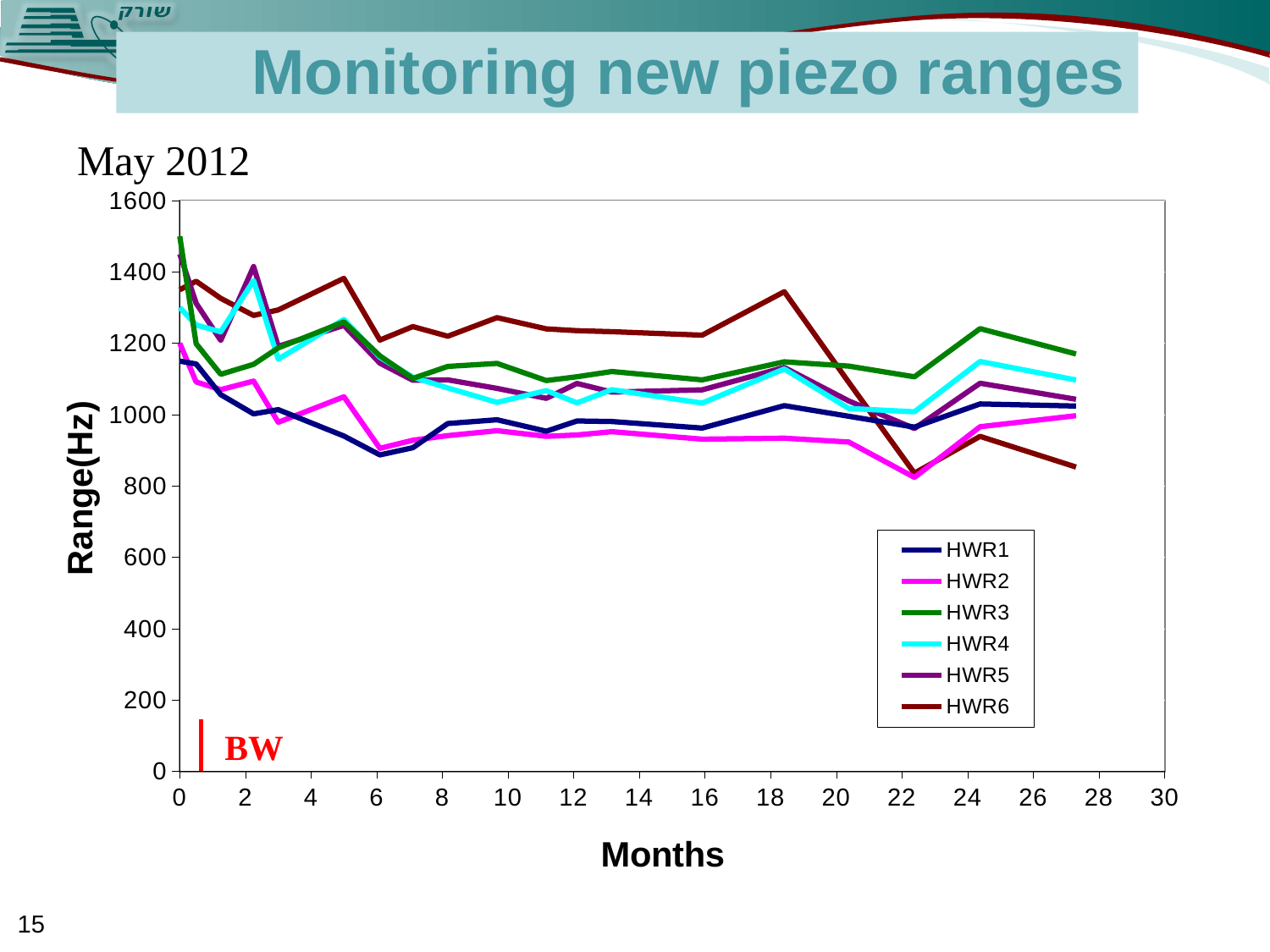
What kind of chart is shown on the slide? line chart Does the HWR6 line rise or fall between month 18 and month 22? fall How many series does the legend list? 6 Is the value for HWR4 at about month 6 greater or less than 1000? greater At about month 18, which is larger, HWR6 or HWR1? HWR6 What is the title of the vertical axis? Range(Hz) Is the value for HWR3 at about month 27 greater or less than 1000? greater Which series has the highest value at about month 10? HWR6 Does the HWR1 line rise or fall between month 0 and month 6? fall What are the series names listed in the legend? HWR1, HWR2, HWR3, HWR4, HWR5, HWR6 Is the value for HWR6 at month 0 greater or less than 1200? greater